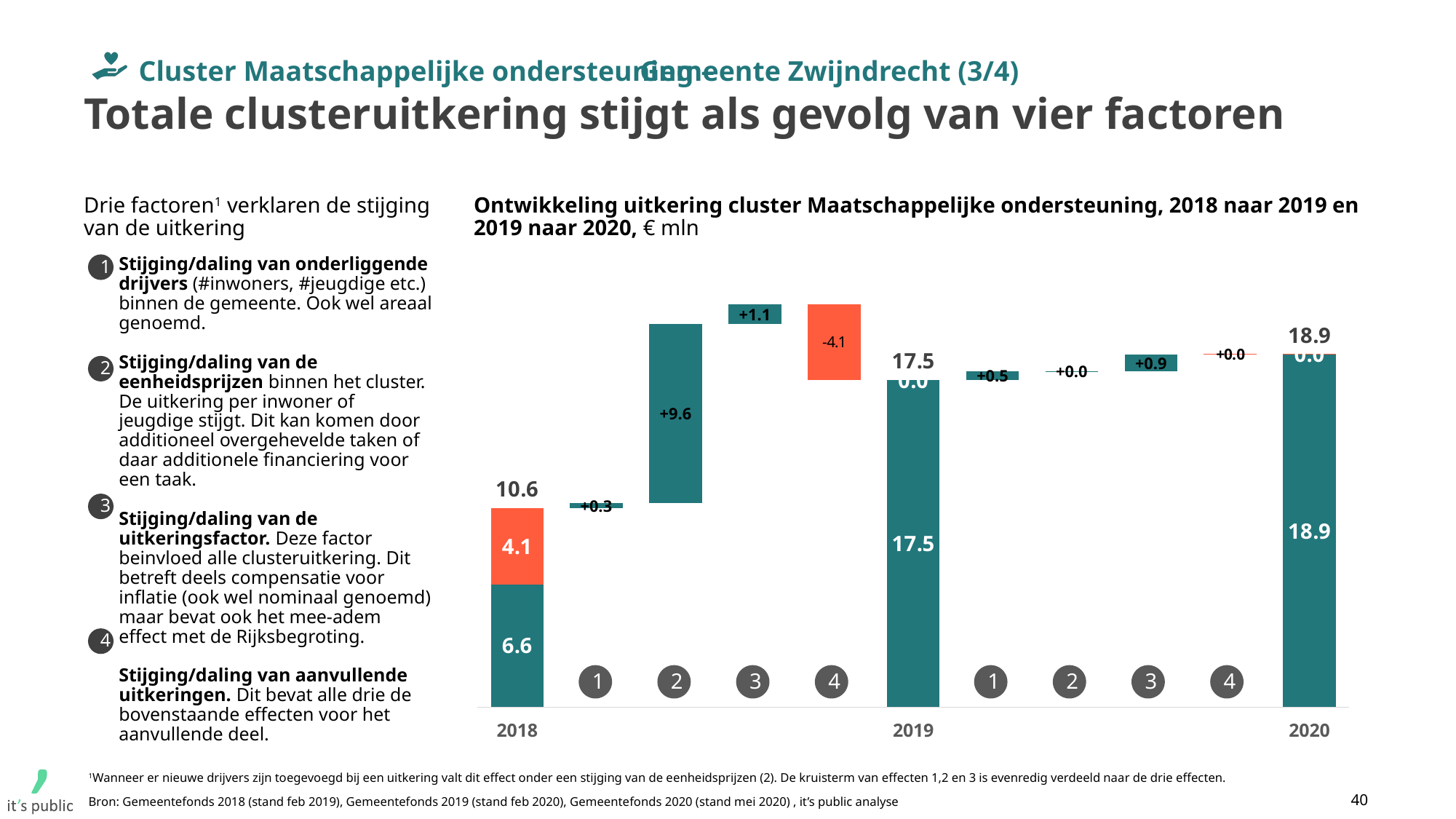
What is the value of the step for factor 2 between 2018 and 2019? +9.6 Which year has the higher total uitkering, 2019 or 2020? 2020 In what unit are the values in the chart expressed? € mln What is the total uitkering shown for 2018? 10.6 Which factor between 2018 and 2019 has a negative step? Factor 4 (-4.1) What is the value of the orange segment in the 2018 bar? 4.1 Which factor has the largest step between 2018 and 2019? Factor 2 (+9.6) By how much does the total uitkering in 2020 exceed the total in 2018? 8.3 What is the value of the step for factor 3 between 2019 and 2020? +0.9 What is the value of the step for factor 4 between 2018 and 2019? -4.1 What is the total uitkering shown for 2020? 18.9 What is the total uitkering shown for 2019? 17.5